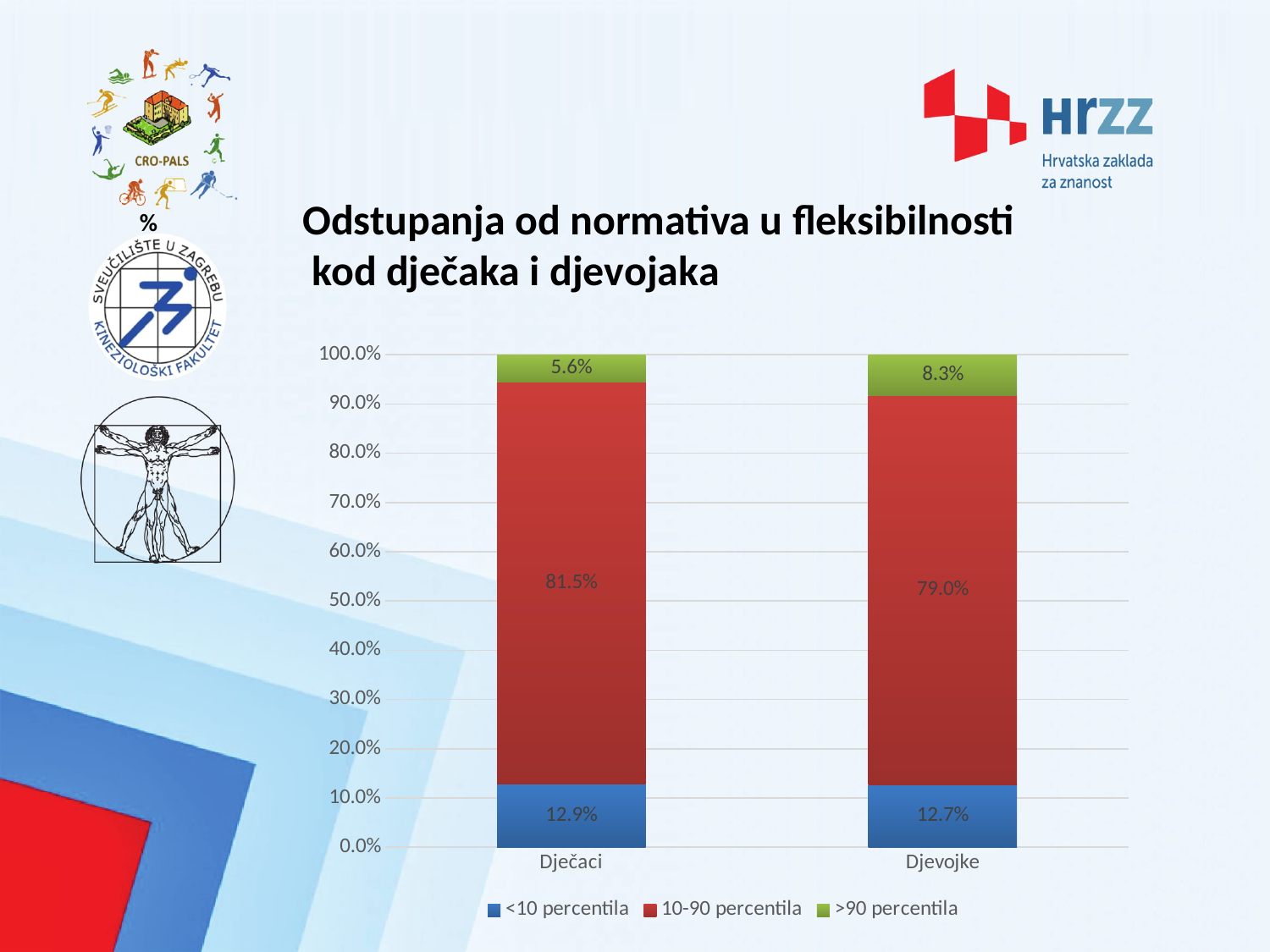
How many categories are shown on the x axis? 2 Is the 10-90 percentila value for Dječaci larger or smaller than the 10-90 percentila value for Djevojke? larger Which category has the lower value for the 10-90 percentila series? Djevojke How many series does the legend list? 3 What is the value of the >90 percentila series for Dječaci? 5.6% What is the value of the <10 percentila series for Djevojke? 12.7% What is the difference between the 10-90 percentila values for Dječaci and Djevojke? 2.5% What is the value of the 10-90 percentila series for Dječaci? 81.5% What is the difference between the >90 percentila values for Djevojke and Dječaci? 2.7% Which category has the higher value for the >90 percentila series? Djevojke What is the value of the >90 percentila series for Djevojke? 8.3% What kind of chart is shown on the slide? stacked bar chart